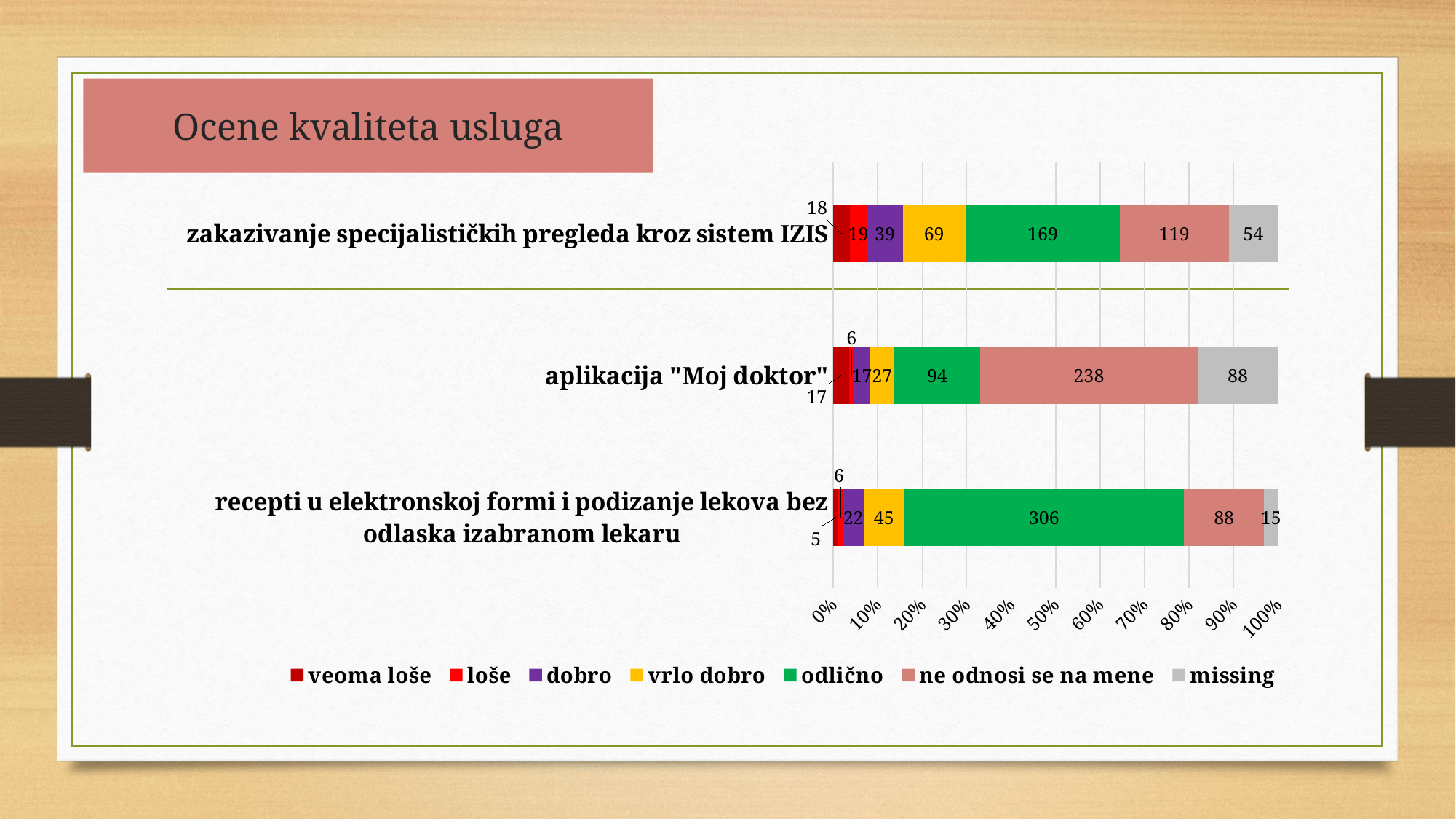
Which service has the highest 'odlično' value? recepti u elektronskoj formi i podizanje lekova bez odlaska izabranom lekaru What is the difference between the 'odlično' values for 'recepti u elektronskoj formi i podizanje lekova bez odlaska izabranom lekaru' and 'zakazivanje specijalističkih pregleda kroz sistem IZIS'? 137 What is the 'odlično' value for 'recepti u elektronskoj formi i podizanje lekova bez odlaska izabranom lekaru'? 306 What is the 'missing' value for 'zakazivanje specijalističkih pregleda kroz sistem IZIS'? 54 How many series does the legend list? 7 How many categories (services) are plotted on the chart? 3 What is the 'ne odnosi se na mene' value for 'aplikacija "Moj doktor"'? 238 What kind of chart is shown on the slide? stacked bar chart What is the 'vrlo dobro' value for 'zakazivanje specijalističkih pregleda kroz sistem IZIS'? 69 What is the title of the slide containing the chart? Ocene kvaliteta usluga Which has the larger 'ne odnosi se na mene' value: 'aplikacija "Moj doktor"' or 'zakazivanje specijalističkih pregleda kroz sistem IZIS'? aplikacija "Moj doktor" What is the 'odlično' value for 'zakazivanje specijalističkih pregleda kroz sistem IZIS'? 169